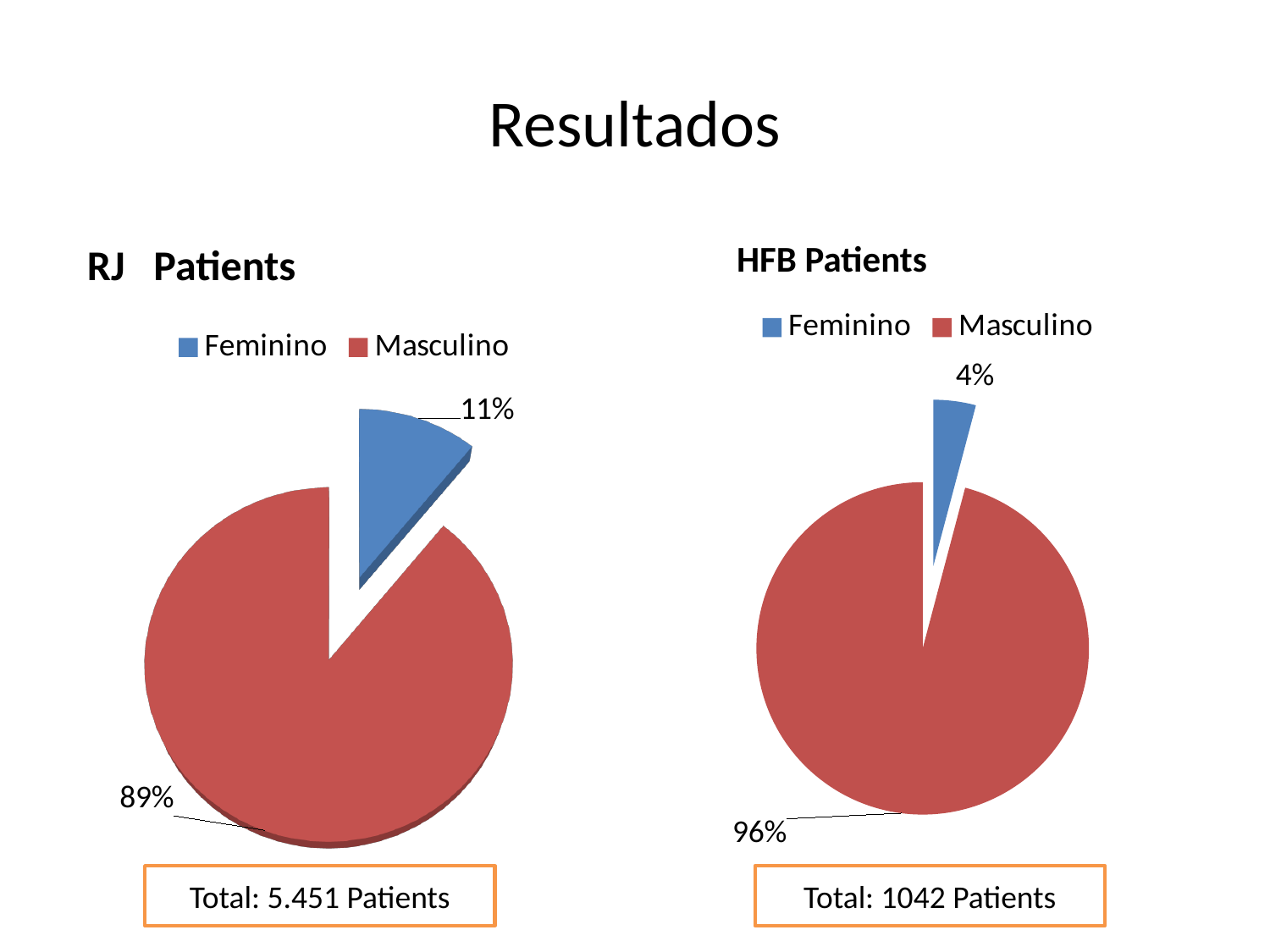
In the HFB Patients chart, which category has the smallest share? Feminino In the RJ Patients chart, what percentage is Feminino? 11% In the RJ Patients chart, which category has the largest share? Masculino What kind of chart is the RJ Patients chart? Pie chart How many series does the legend of the RJ Patients chart list? 2 What colour represents Masculino in the HFB Patients chart? Red In the HFB Patients chart, what percentage is Masculino? 96% In the HFB Patients chart, what percentage is Feminino? 4% Which chart has the larger Feminino share, RJ Patients or HFB Patients? RJ Patients In the RJ Patients chart, what percentage is Masculino? 89% How many categories does the HFB Patients chart show? 2 In the RJ Patients chart, what is the difference in percentage points between Masculino and Feminino? 78